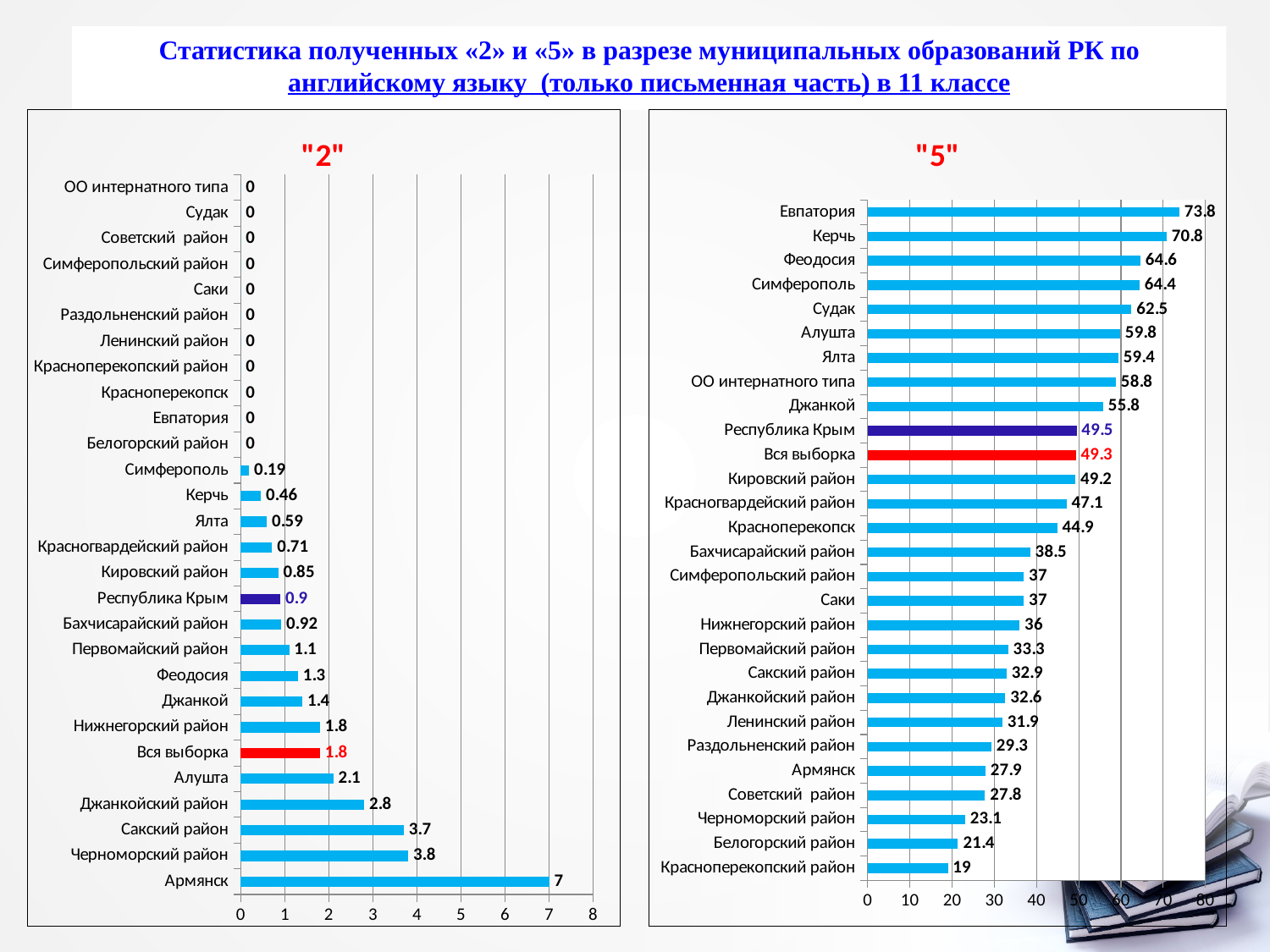
In the "5" chart, what is the value for Бахчисарайский район? 38.5 In the "2" chart, what is the value for Армянск? 7 In the "2" chart, what is the difference between the values for Черноморский район and Сакский район? 0.1 In the "5" chart, which category has the lowest value? Красноперекопский район In the "2" chart, how many categories are plotted? 28 In the "5" chart, what is the difference between the values for Республика Крым and Вся выборка? 0.2 In the "2" chart, what is the value for Республика Крым? 0.9 In the "2" chart, which category has the highest value? Армянск In the "5" chart, which is larger, the value for Керчь or the value for Феодосия? Керчь What type of chart is the "5" chart? Bar chart In the "5" chart, what is the value for Евпатория? 73.8 In the "2" chart, what colour is the bar for Вся выборка? Red